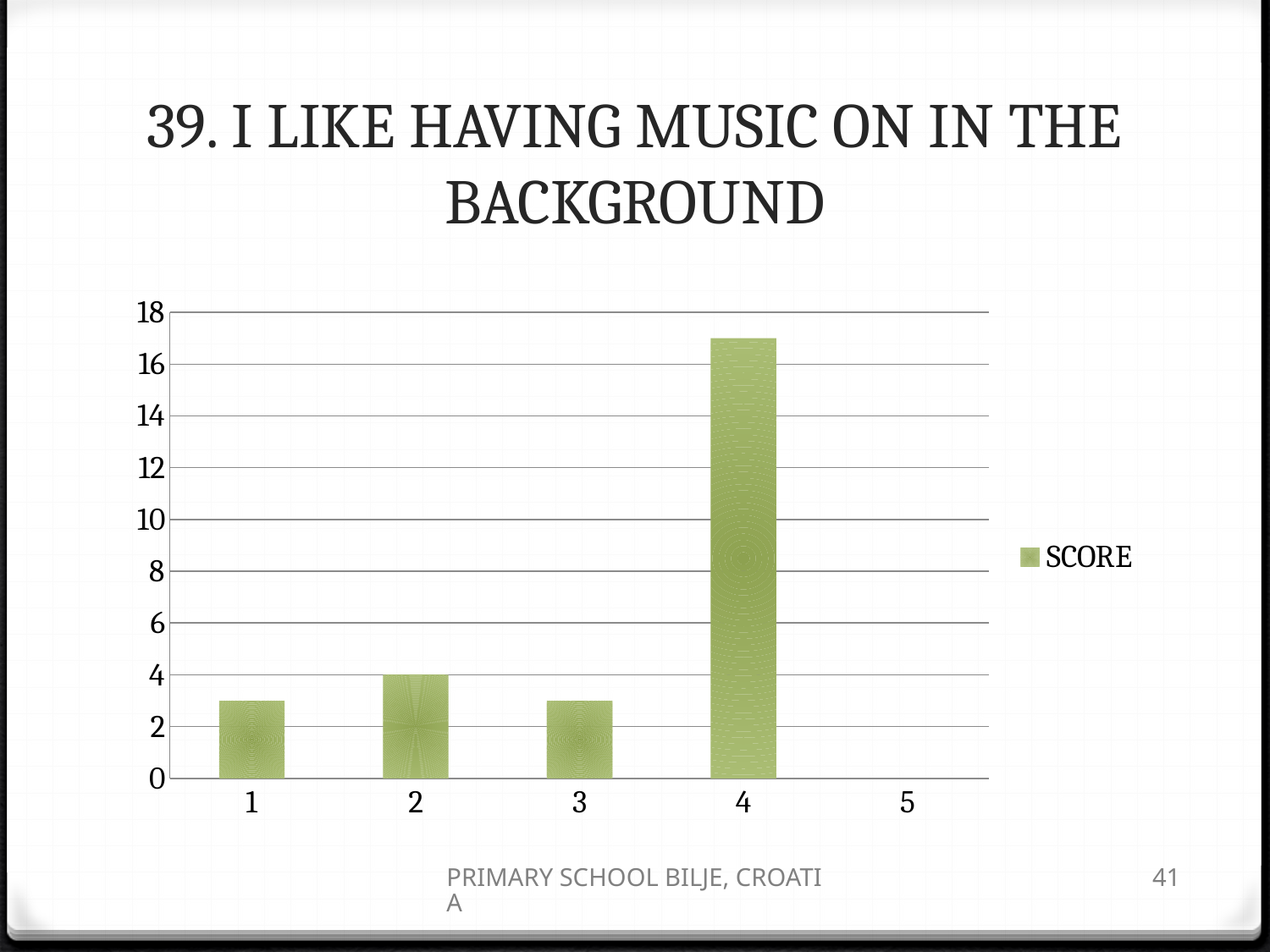
Which category has the lowest score? 5 Is the score for category 4 greater or less than 16? greater How many categories are shown on the x axis? 5 Which has a higher score, category 4 or category 2? 4 How many series does the legend list? 1 What kind of chart is shown on the slide? bar chart Is the score for category 3 greater or less than 2? greater Is the score for category 1 greater or less than 4? less Which category has the highest score? 4 What is the score for category 5? 0 What is the score for category 2? 4 What is the name of the series shown in the legend? SCORE